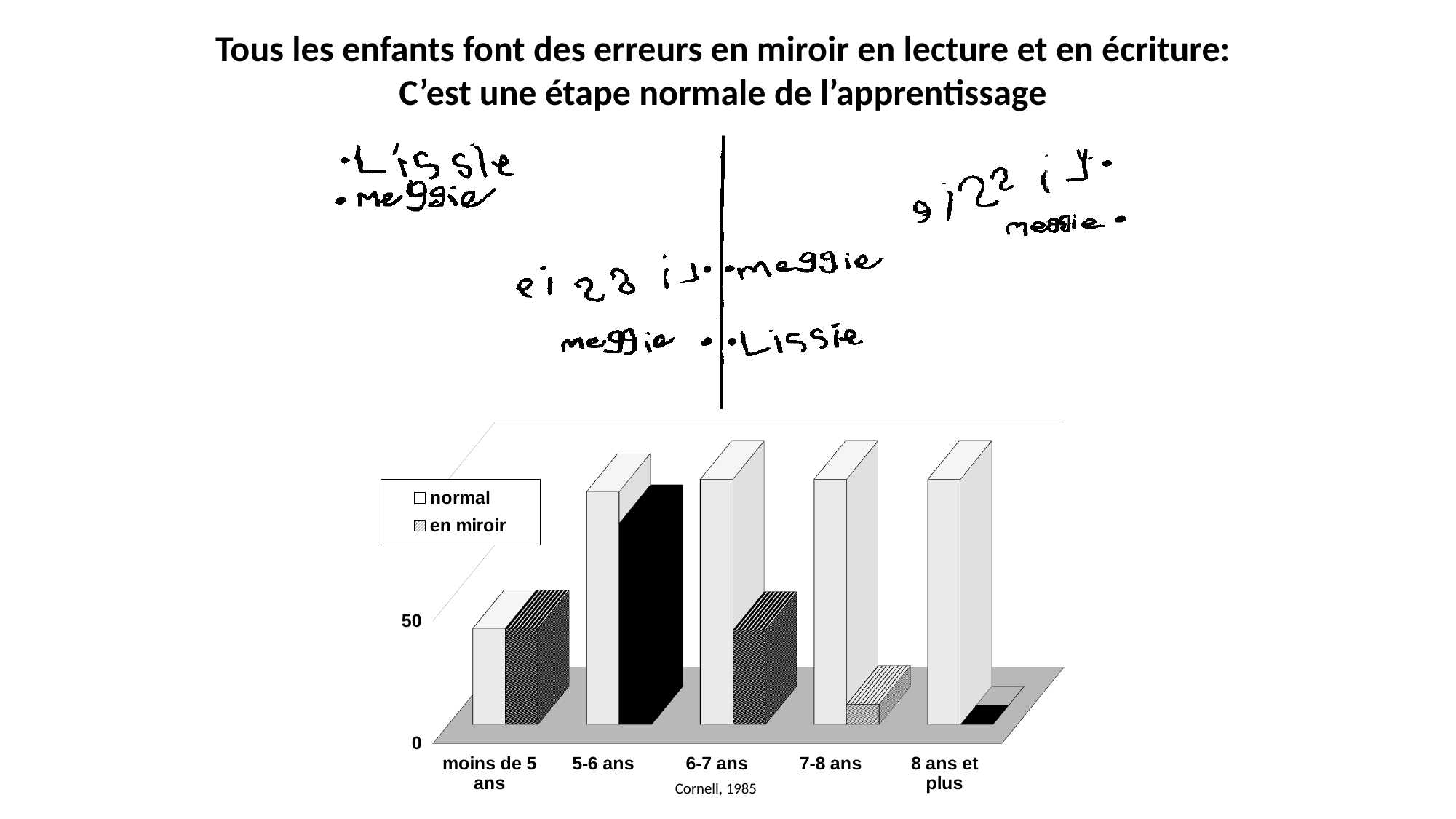
What kind of chart is shown on the slide? bar chart Which age category has the highest value for the 'en miroir' series? 5-6 ans Which age category has the lowest value for the 'normal' series? moins de 5 ans For 7-8 ans, which series has the larger value, 'normal' or 'en miroir'? normal Which age category has the lowest value for the 'en miroir' series? 8 ans et plus How many series does the chart's legend list? 2 What are the two series named in the chart's legend? normal, en miroir Is the 'en miroir' value for 7-8 ans greater or less than 50? less Is the 'en miroir' value for 8 ans et plus greater or less than 50? less From 5-6 ans to 8 ans et plus, do the 'en miroir' values rise or fall? fall How many age categories are shown on the x axis of the chart? 5 Is the 'normal' value for 6-7 ans greater or less than 50? greater